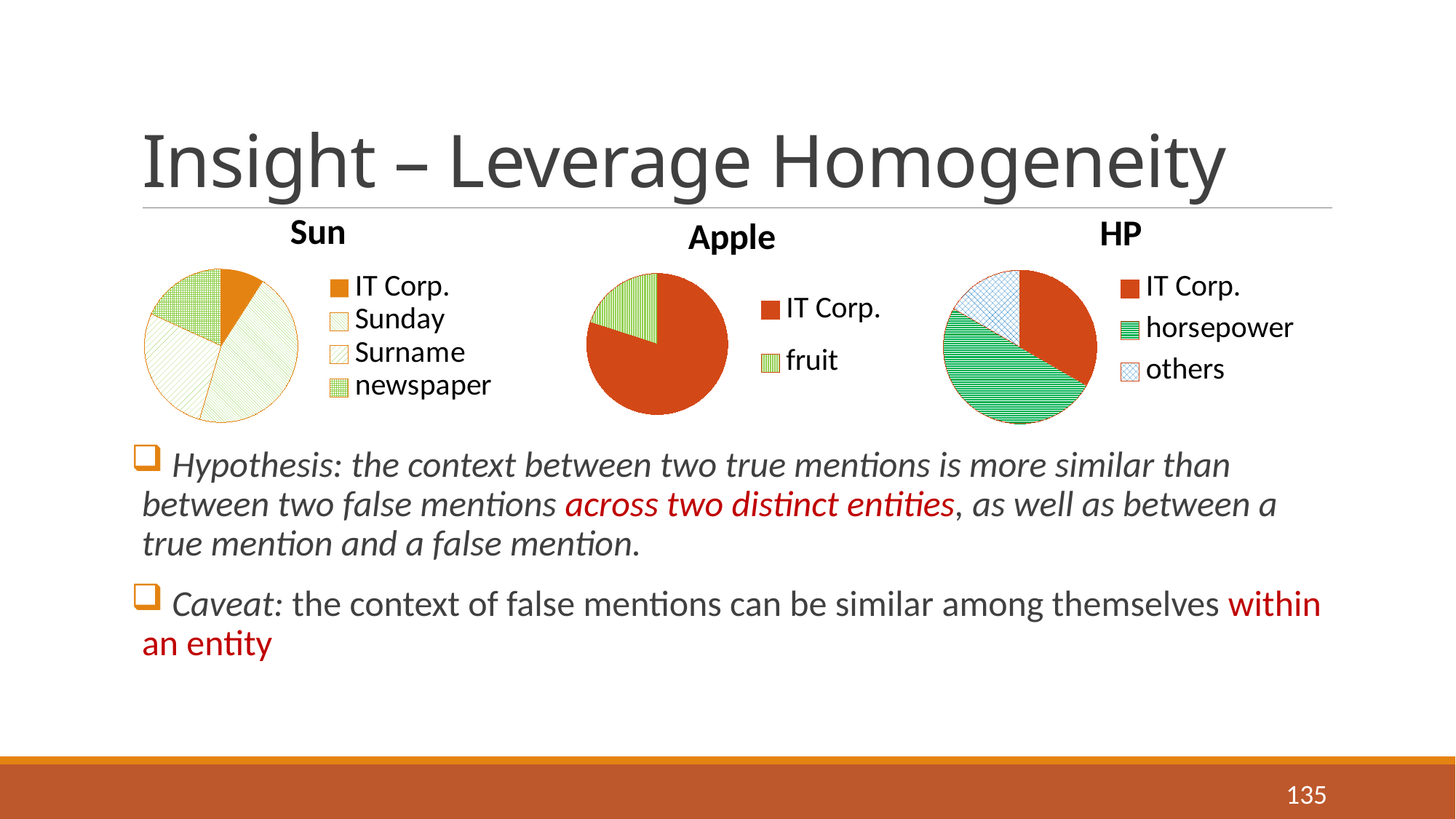
In the HP chart, which slice is larger: IT Corp. or others? IT Corp. In the Sun chart, which category has the smallest slice? IT Corp. In the Sun chart, which category has the largest slice? Sunday What kind of chart is the Sun chart? pie chart In the HP chart, which category has the smallest slice? others What are the titles of the three pie charts on the slide, from left to right? Sun, Apple, HP How many entries does the legend of the Apple chart list? 2 In the HP chart, which category has the largest slice? horsepower In the Apple chart, which category has the larger slice? IT Corp. In the Sun chart, which slice is larger: Sunday or IT Corp.? Sunday How many slices does the HP pie chart have? 3 How many slices does the Sun pie chart have? 4